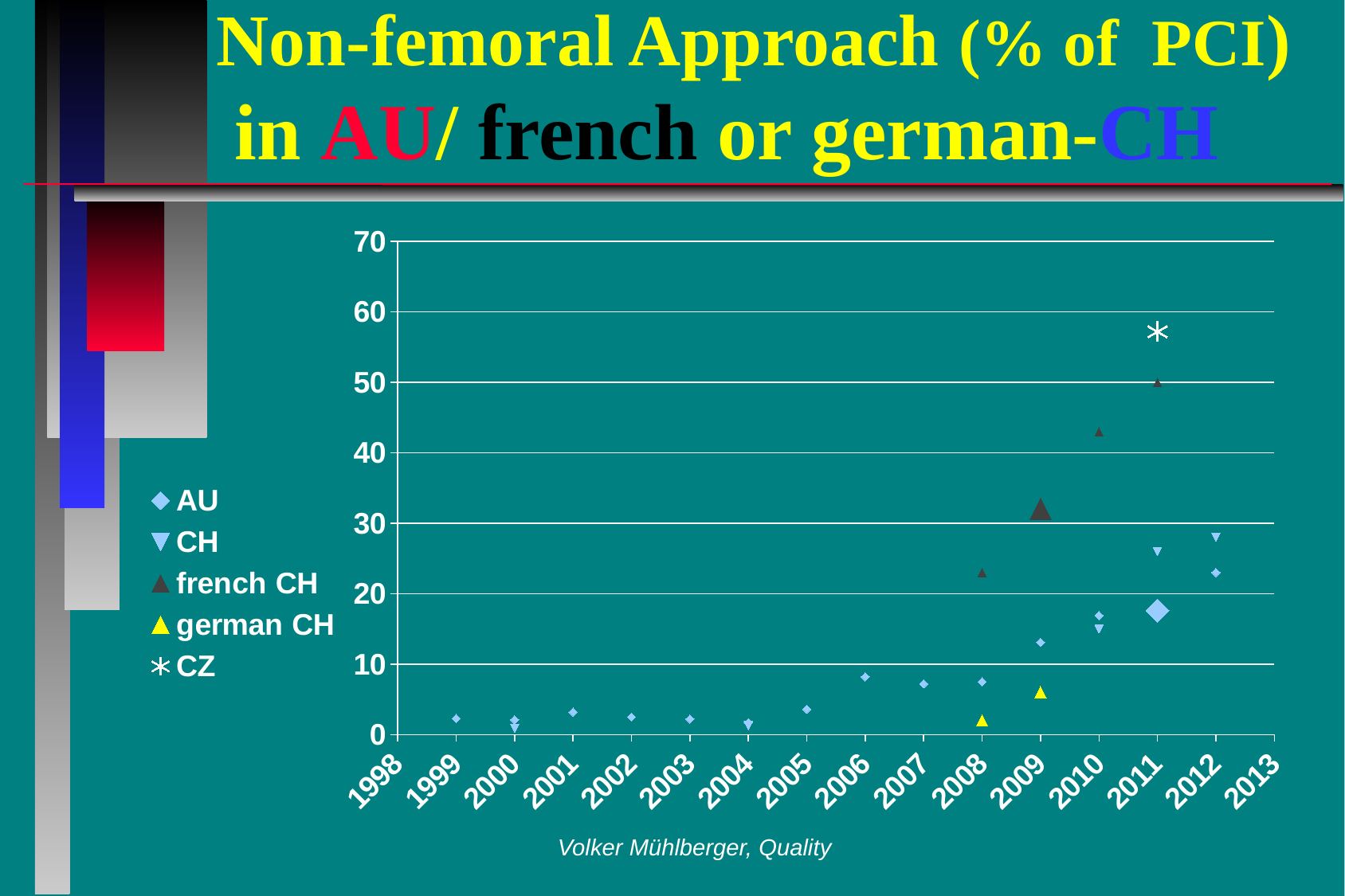
Is the value for AU in 2012 greater or less than 20? greater What kind of chart is shown on the slide? scatter chart How many series does the legend list? 5 In 2009, which is larger, the value for AU or the value for german CH? AU Which series are listed in the legend? AU, CH, french CH, german CH, CZ Is the value for CH in 2012 greater or less than 30? less Which series has the highest value in 2011? CZ Is the value for french CH in 2010 greater or less than 40? greater Do the AU values generally rise or fall from 1999 to 2012? rise In 2011, which is larger, the value for french CH or the value for AU? french CH